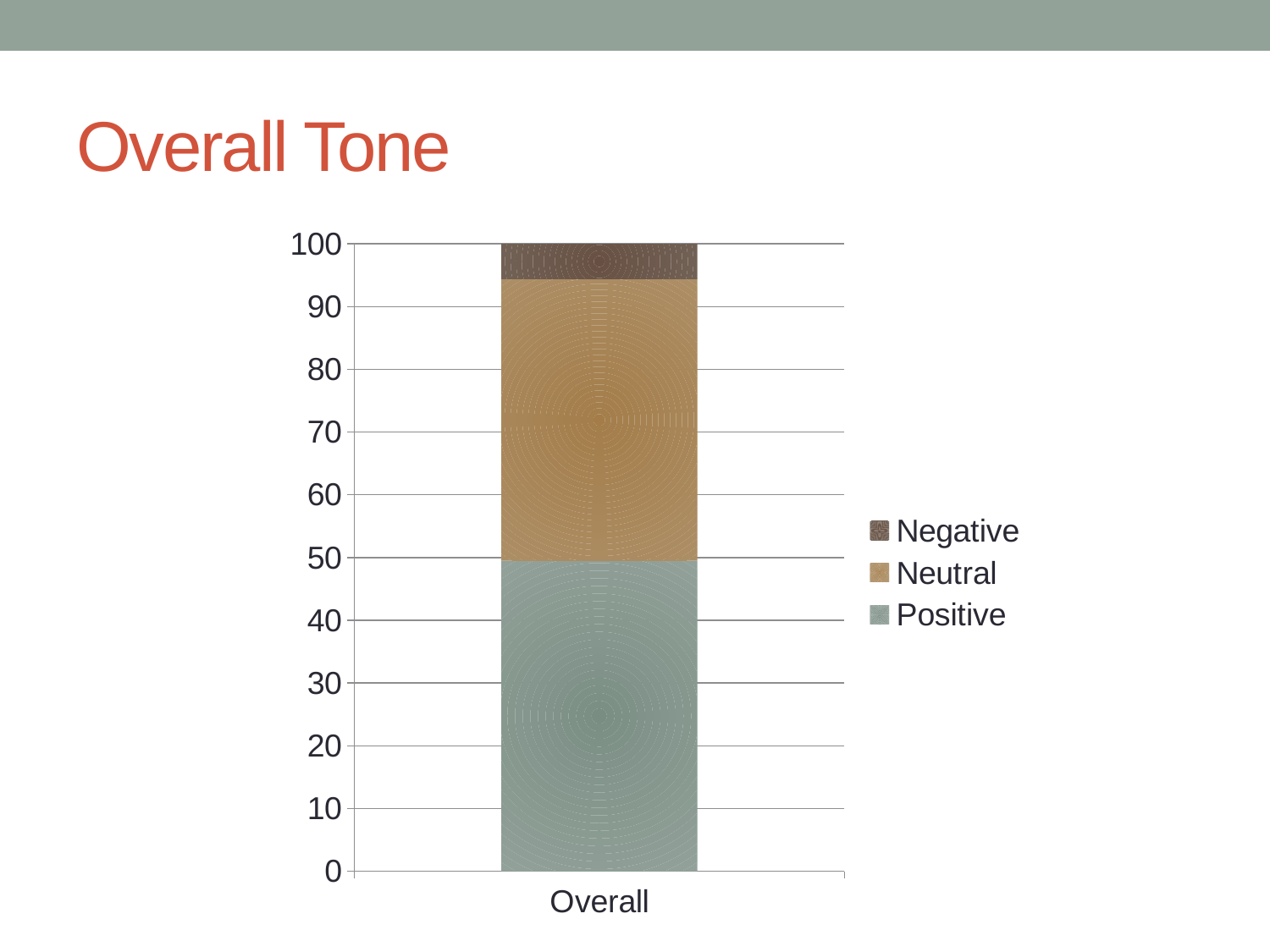
Which series are listed in the legend? Negative, Neutral, Positive Which is larger in the Overall bar, the Neutral segment or the Negative segment? Neutral How many series does the legend list? 3 What kind of chart is shown on the slide? stacked bar chart What is the total height of the stacked bar for Overall? 100 Is the Positive segment of the Overall bar greater or less than 40? greater Is the Neutral segment of the Overall bar greater or less than 30? greater Which series has the smallest segment in the Overall bar? Negative Is the Negative segment of the Overall bar greater or less than 10? less How many categories are shown on the x axis? 1 What is the label of the single category on the x axis? Overall What is the title of the slide containing the chart? Overall Tone